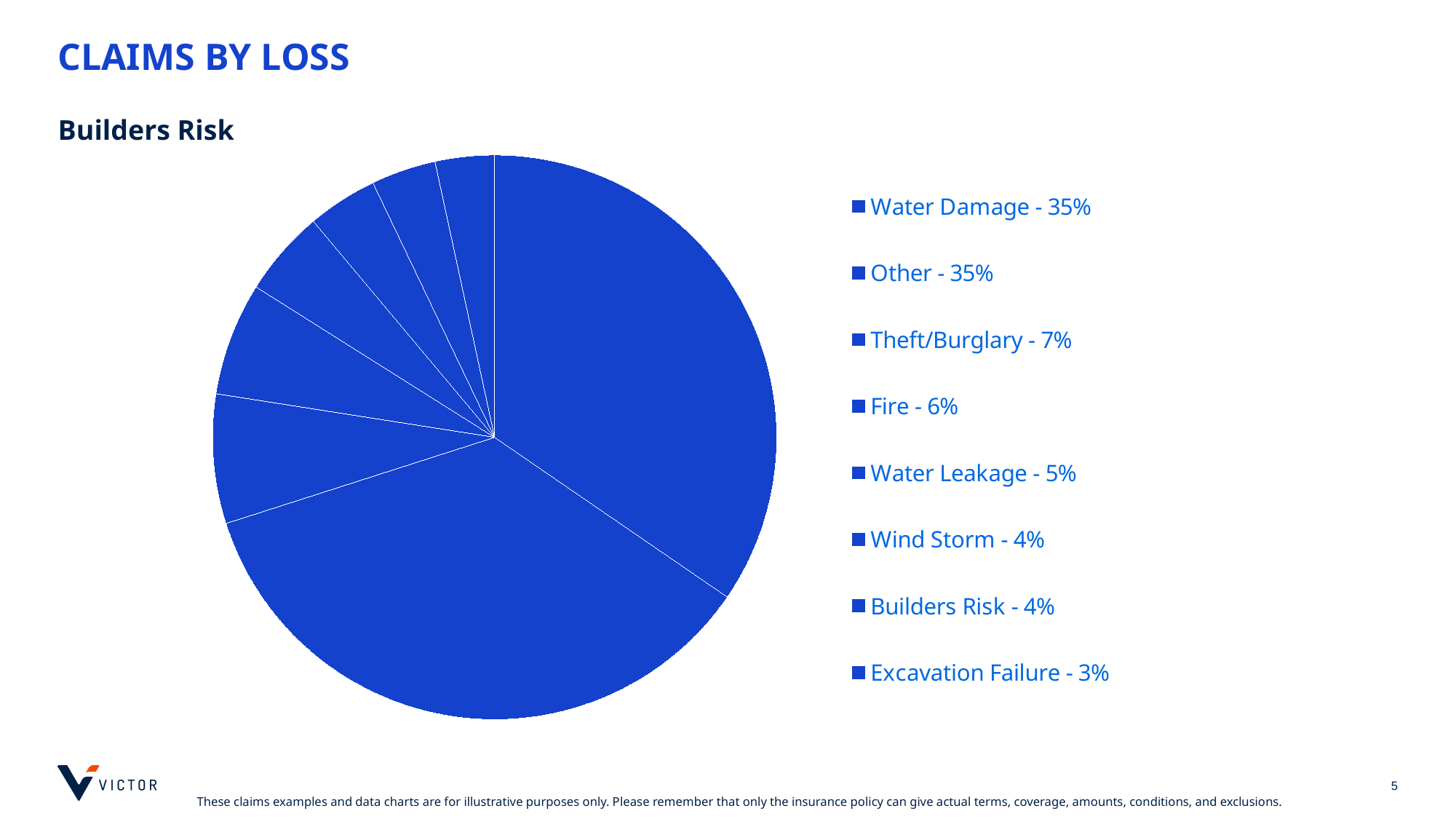
What share of the pie does Water Damage represent? 35% How many categories does the pie chart show? 8 Which is larger, the share for Fire or the share for Water Leakage? Fire What percentage of claims is Excavation Failure? 3% What is the title of the slide containing the pie chart? CLAIMS BY LOSS What is the combined share of Water Damage and Other? 70% What share of claims is attributed to Theft/Burglary? 7% What percentage of claims is Fire? 6% What percentage of claims is Water Leakage? 5% What is the difference between the Theft/Burglary share and the Fire share? 1% Which category has the smallest share of claims? Excavation Failure What kind of chart is shown on the slide? pie chart